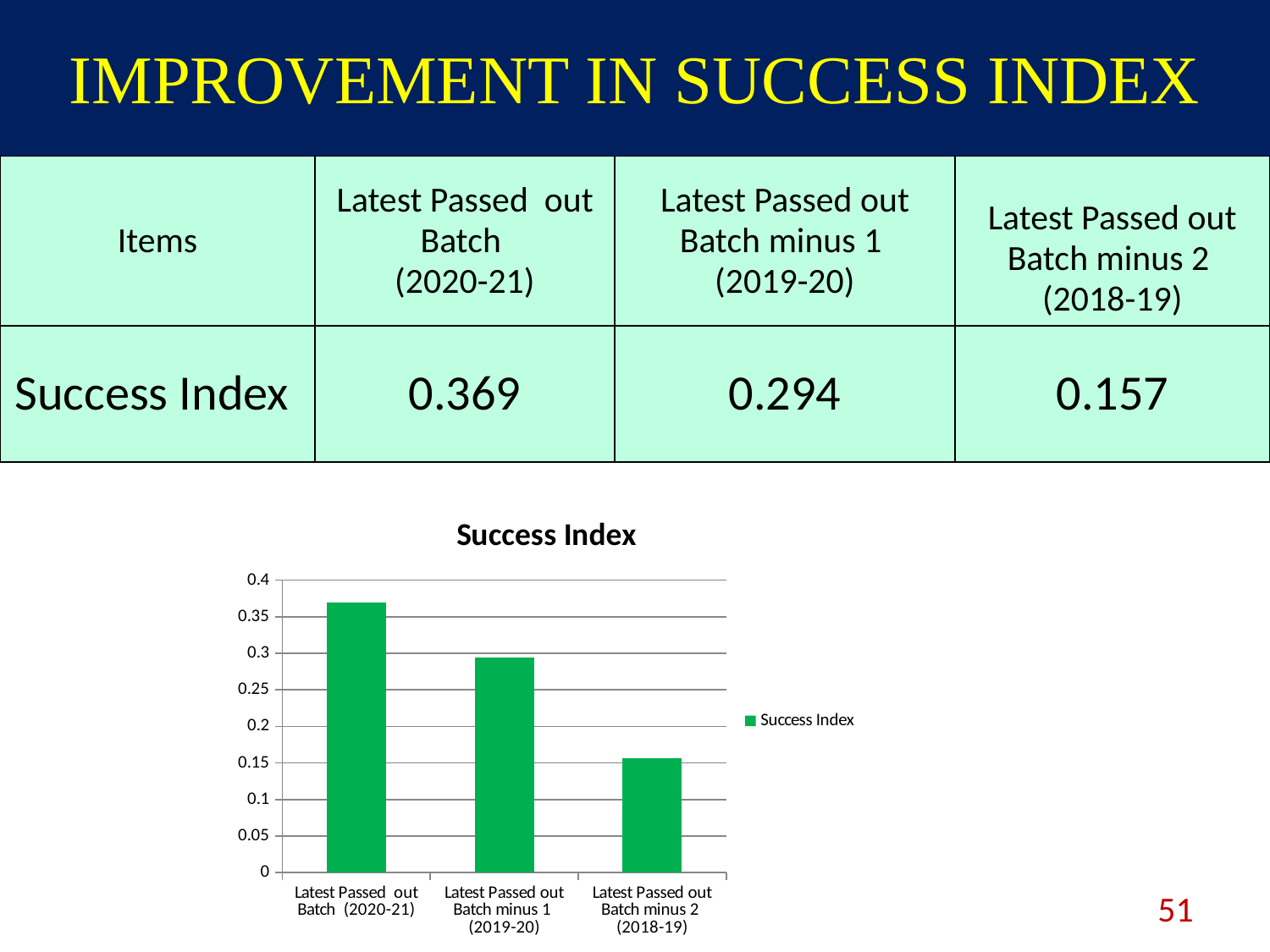
What is the Success Index for the Latest Passed out Batch (2020-21)? 0.369 What type of chart is shown on the slide? bar chart How many bars are plotted in the chart? 3 Which batch has the highest Success Index in the chart? Latest Passed out Batch (2020-21) What is the difference between the Success Index for the Latest Passed out Batch (2020-21) and the Latest Passed out Batch minus 2 (2018-19)? 0.212 Which batch has the lowest Success Index in the chart? Latest Passed out Batch minus 2 (2018-19) What is the Success Index for the Latest Passed out Batch minus 2 (2018-19)? 0.157 Is the Success Index for the Latest Passed out Batch minus 2 (2018-19) greater or less than 0.2? less How many series does the chart legend list? 1 What is the title of the chart? Success Index Is the Success Index for the Latest Passed out Batch minus 1 (2019-20) greater or less than 0.25? greater Which is larger, the Success Index for the Latest Passed out Batch (2020-21) or for the Latest Passed out Batch minus 1 (2019-20)? Latest Passed out Batch (2020-21)